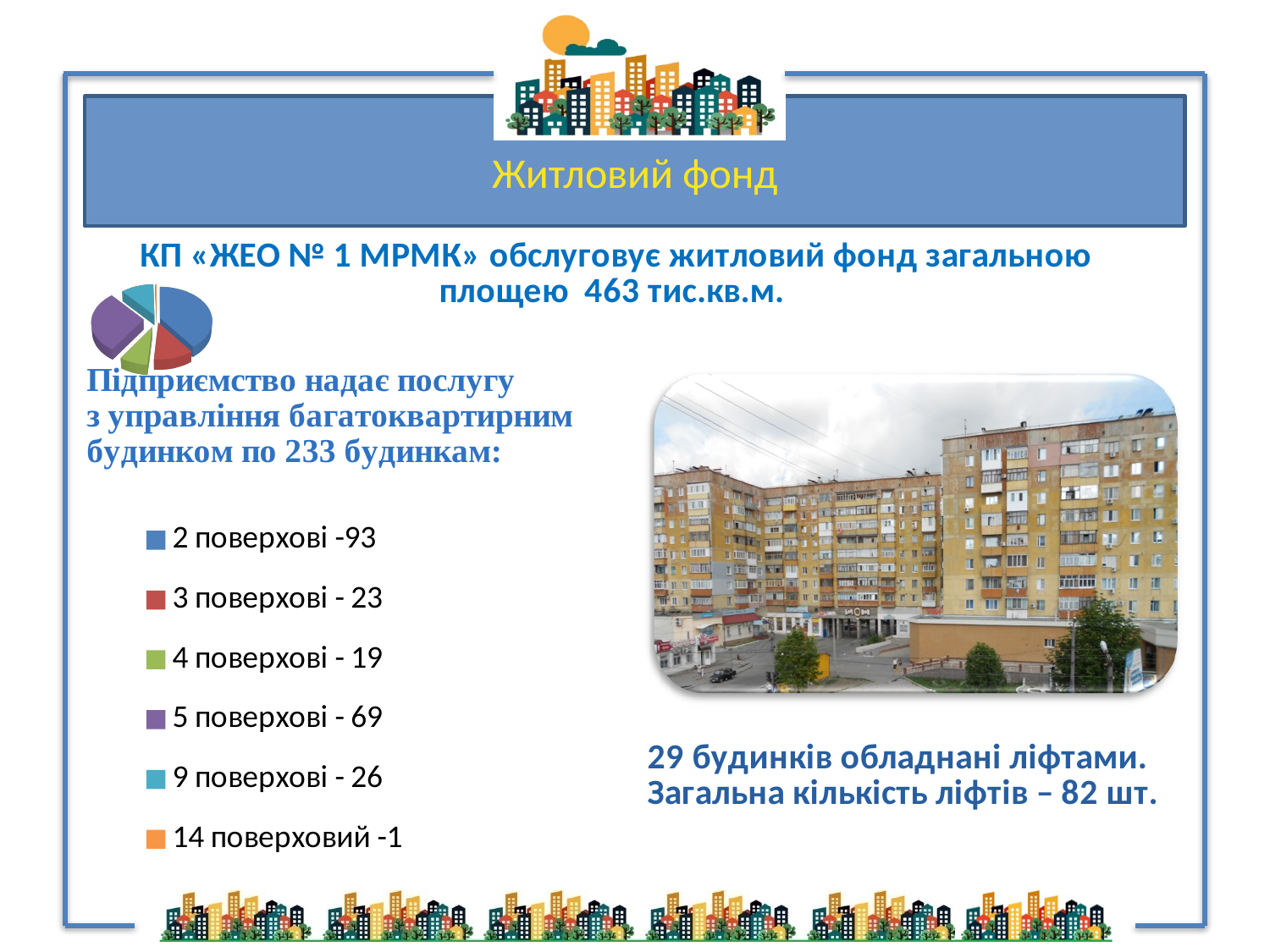
Which category has the lowest value in the pie chart? 14 поверховий What is the value for the category "14 поверховий" in the pie chart legend? 1 What is the value for the category "9 поверхові" in the pie chart legend? 26 What type of chart is shown on the slide? pie chart Which is larger in the pie chart: the value for "3 поверхові" or "4 поверхові"? 3 поверхові Which category has the highest value in the pie chart? 2 поверхові What is the value for the category "5 поверхові" in the pie chart legend? 69 What is the difference between the values for "2 поверхові" and "5 поверхові"? 24 What colour represents the category "4 поверхові" in the pie chart legend? green How many categories does the pie chart's legend list? 6 What is the value for the category "2 поверхові" in the pie chart legend? 93 What is the difference between the values for "9 поверхові" and "3 поверхові"? 3